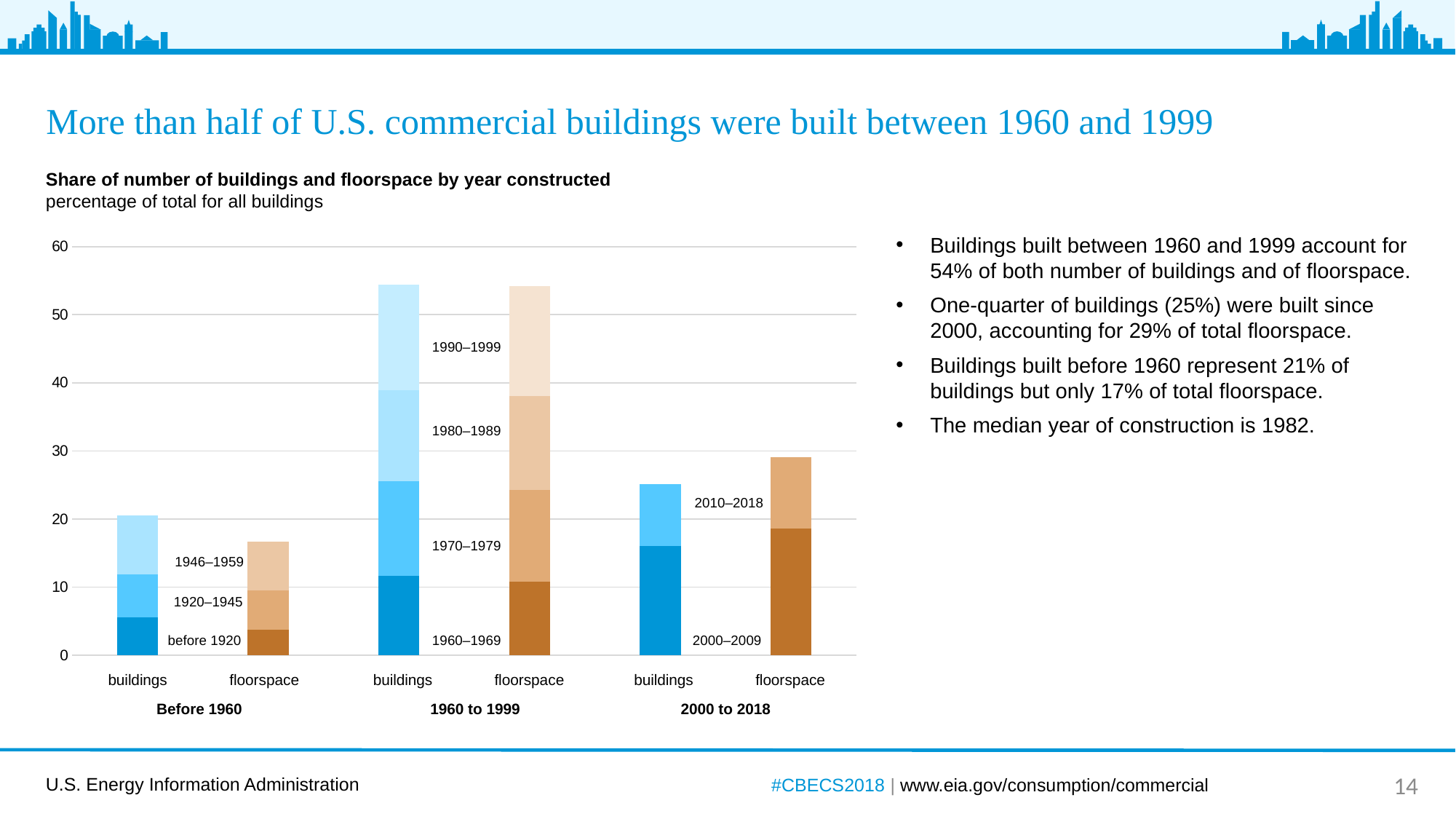
How many bars are plotted in the chart? 6 Is the buildings bar for 2000 to 2018 greater or less than 20? greater Is the floorspace bar for Before 1960 greater or less than 20? less According to the slide, what share of total floorspace do buildings built between 1960 and 1999 account for? 54% Which construction-period group has the tallest bars in the chart? 1960 to 1999 Which bar is the shortest in the chart? floorspace, Before 1960 How many construction-period groups are shown along the x axis of the chart? 3 What is the title of the chart? Share of number of buildings and floorspace by year constructed Is the buildings bar for 1960 to 1999 greater or less than 50? greater In the Before 1960 group, which bar is taller: buildings or floorspace? buildings What kind of chart is shown on the slide? stacked bar chart In the 2000 to 2018 group, which bar is taller: buildings or floorspace? floorspace